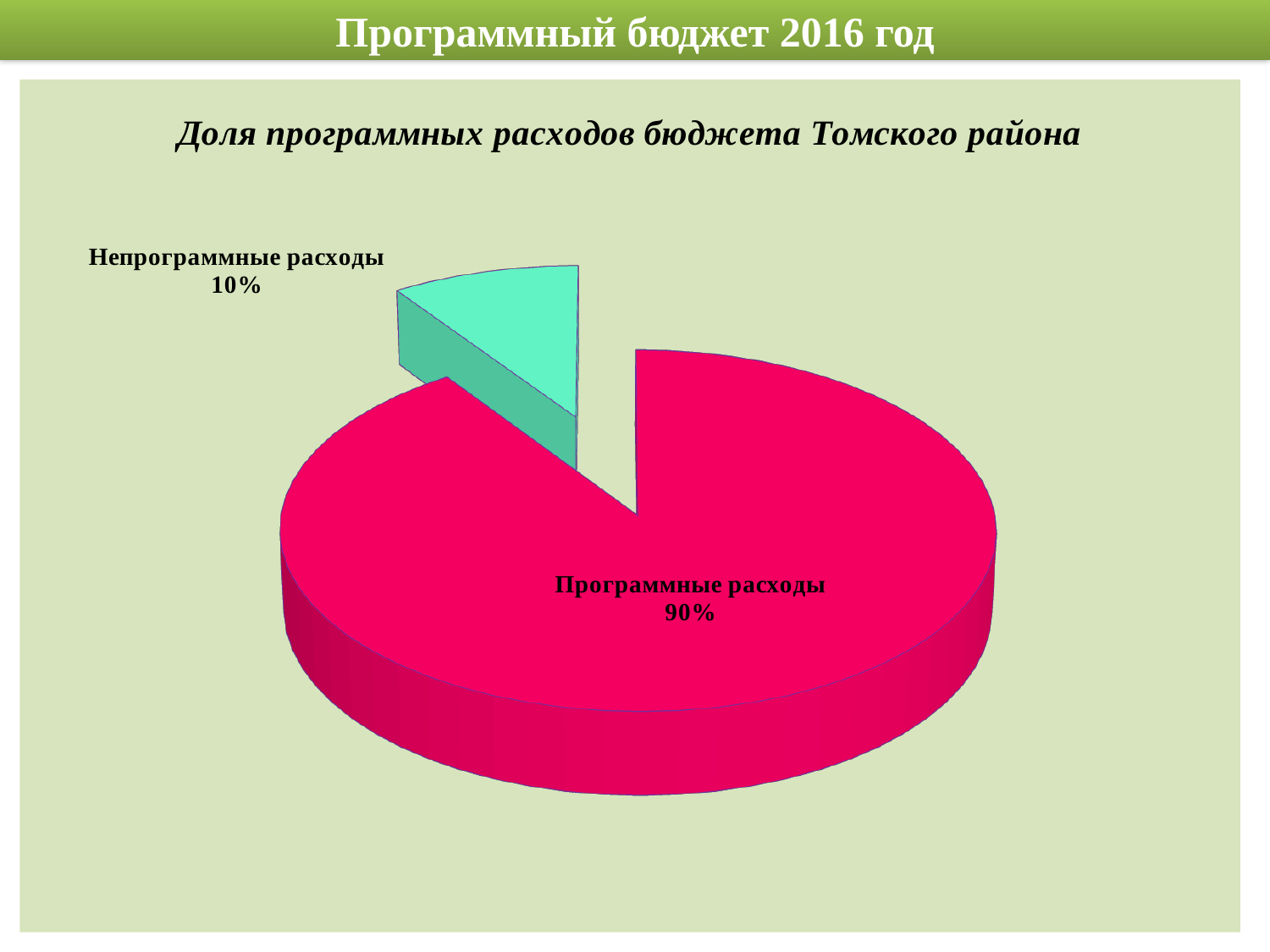
What colour is the "Непрограммные расходы" slice? Green What type of chart is shown on the slide? Pie chart Which slice is the smallest in the pie chart? Непрограммные расходы What is the difference in percentage points between "Программные расходы" and "Непрограммные расходы"? 80 What share of the pie does "Программные расходы" represent? 90% What share of the pie does "Непрограммные расходы" represent? 10% Which is larger: "Программные расходы" or "Непрограммные расходы"? Программные расходы How many slices does the pie chart have? 2 What is the title of the chart? Доля программных расходов бюджета Томского района Which slice is the largest in the pie chart? Программные расходы